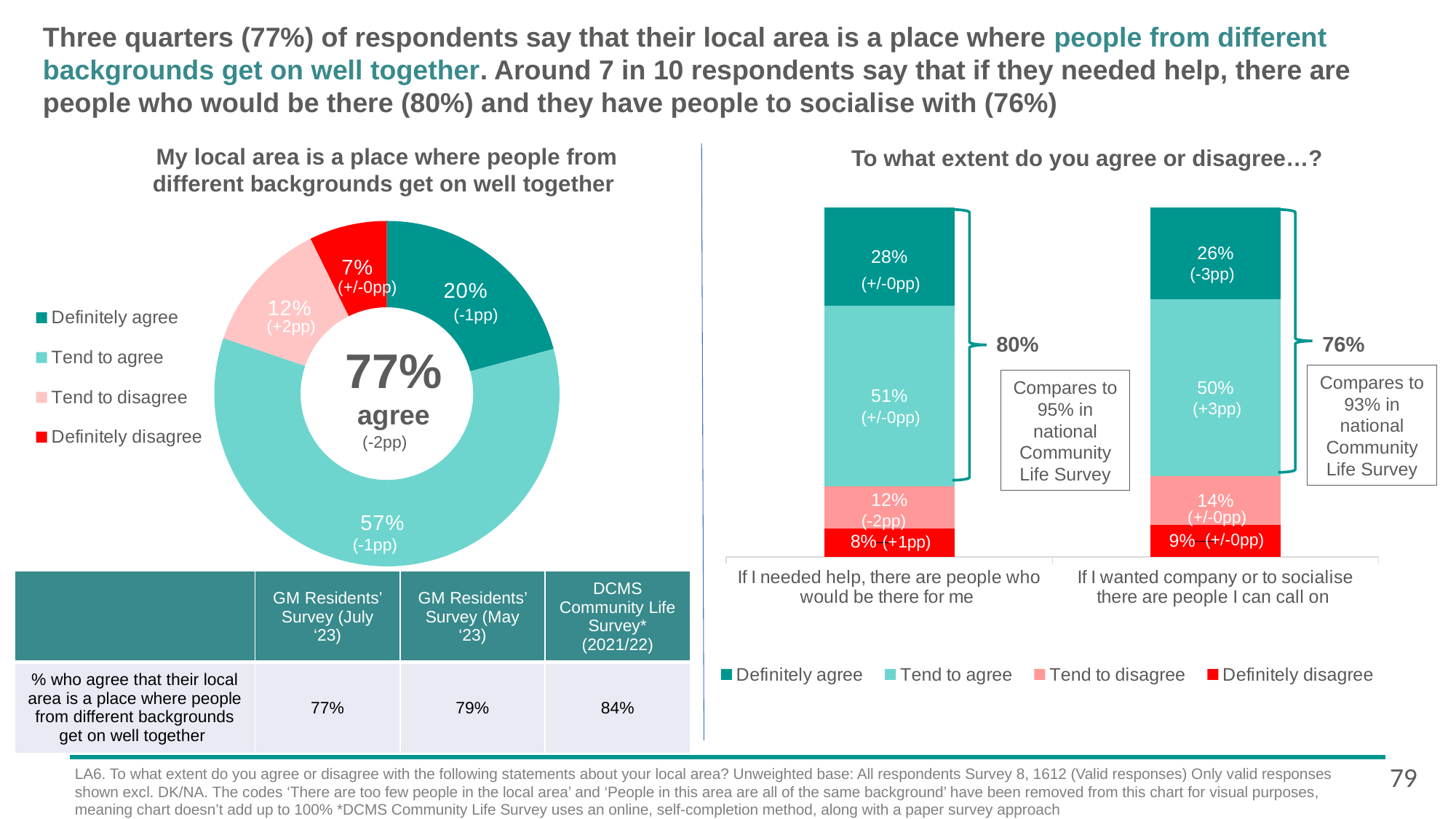
In the donut chart on the left, what is the difference between the 'Definitely agree' share and the 'Tend to disagree' share? 8 percentage points In the donut chart on the left, what overall percentage is shown in the centre as agreeing? 77% What type of chart is shown on the right side of the slide? Stacked bar chart In the stacked bar chart on the right, what is the combined agree percentage shown for 'If I wanted company or to socialise there are people I can call on'? 76% In the stacked bar chart on the right, which statement has the higher 'Tend to agree' percentage: 'If I needed help, there are people who would be there for me' or 'If I wanted company or to socialise there are people I can call on'? If I needed help, there are people who would be there for me In the donut chart on the left, which response category has the smallest share? Definitely disagree In the donut chart on the left, what percentage of respondents 'Definitely disagree'? 7% In the donut chart on the left, which response category has the largest share? Tend to agree In the donut chart titled 'My local area is a place where people from different backgrounds get on well together', what percentage of respondents 'Tend to agree'? 57% In the stacked bar chart on the right, what percentage 'Tend to disagree' that if they wanted company or to socialise there are people they can call on? 14% In the stacked bar chart titled 'To what extent do you agree or disagree…?', what percentage 'Definitely agree' that if they needed help, there are people who would be there for them? 28% How many series does the legend of the stacked bar chart on the right list? 4